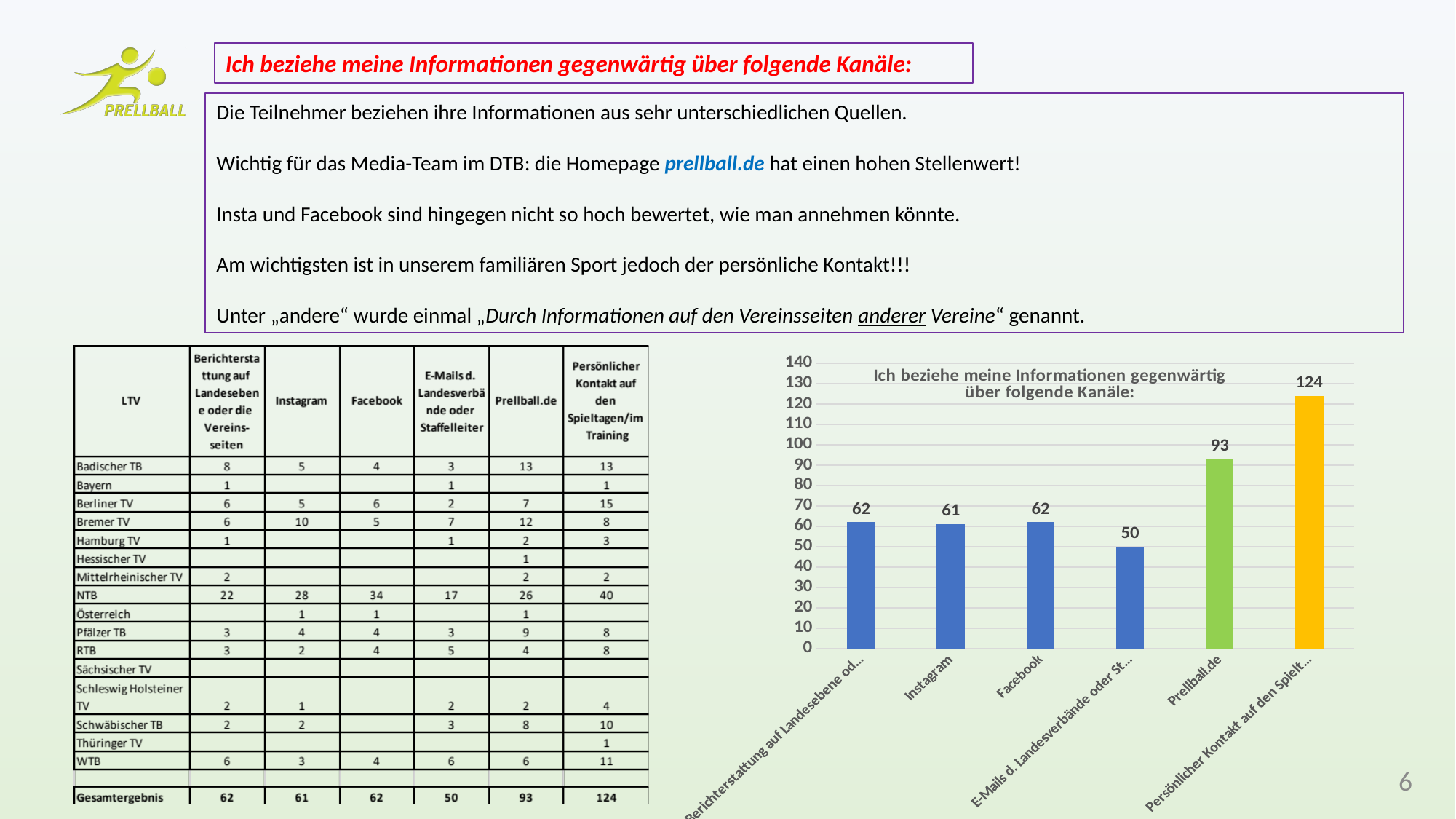
What is the value for Facebook in the bar chart? 62 Which is larger in the bar chart: the value for Prellball.de or the value for Instagram? Prellball.de What is the difference between the value for Facebook and the value for E-Mails d. Landesverbände? 12 Which category has the highest value in the bar chart? Persönlicher Kontakt auf den Spielt... Is the value for Persönlicher Kontakt greater or less than 120? greater What type of chart is shown on the slide? bar chart What is the value for Prellball.de in the bar chart? 93 Which category has the lowest value in the bar chart? E-Mails d. Landesverbände oder St... How many categories are shown in the bar chart? 6 What is the value for Instagram in the bar chart? 61 What is the difference between the value for Persönlicher Kontakt and the value for Prellball.de? 31 What colour is the bar for Prellball.de? green